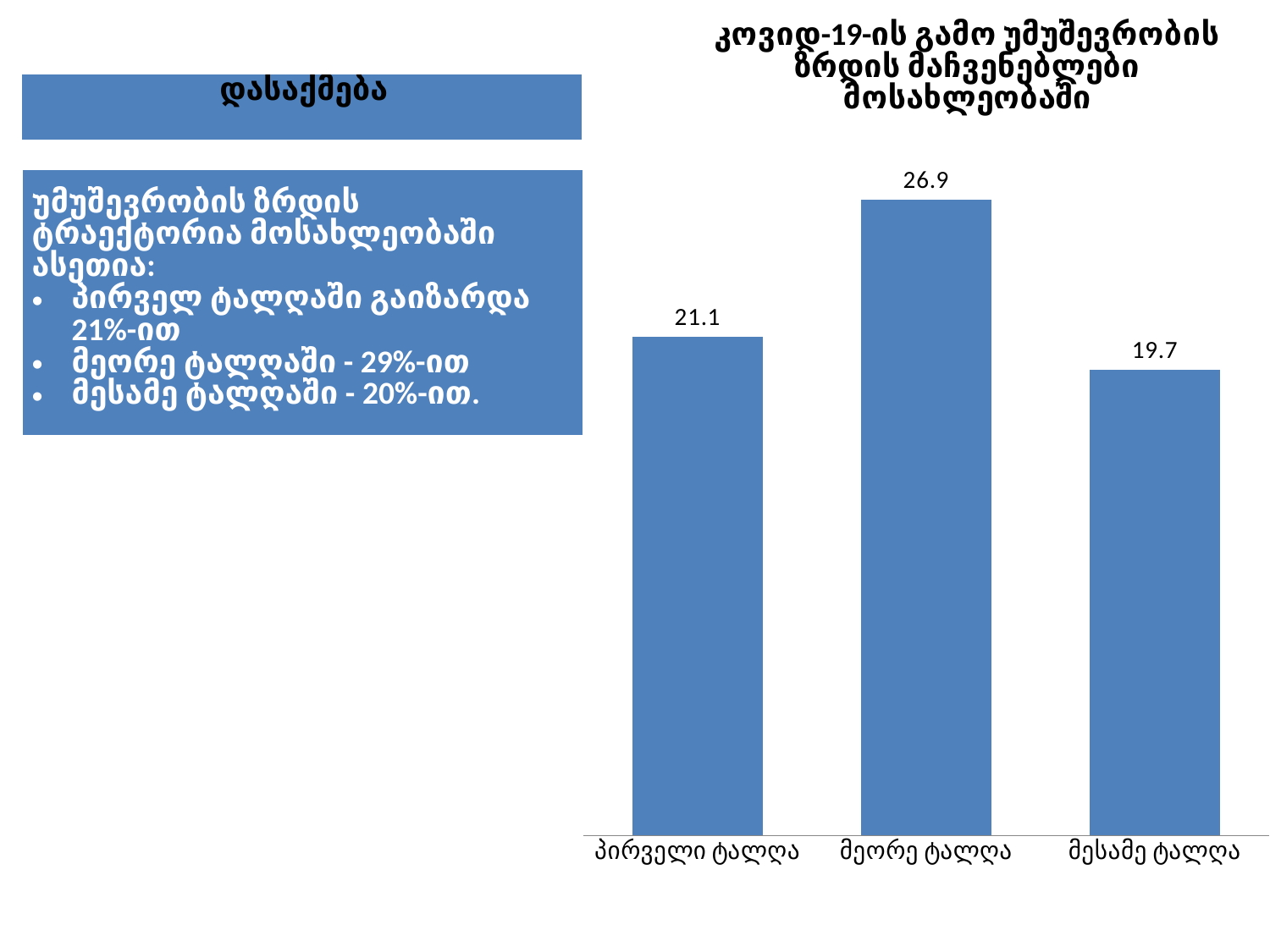
Which is larger, the value for მეორე ტალღა or the value for მესამე ტალღა? მეორე ტალღა Which category has the highest value? მეორე ტალღა Which category has the lowest value? მესამე ტალღა Does the value rise or fall from მეორე ტალღა to მესამე ტალღა? fall What kind of chart is shown on the slide? bar chart How many categories are shown in the chart? 3 What is the value for პირველი ტალღა? 21.1 What is the title of the chart? კოვიდ-19-ის გამო უმუშევრობის ზრდის მაჩვენებლები მოსახლეობაში What is the difference between the values for პირველი ტალღა and მესამე ტალღა? 1.4 What is the difference between the values for მეორე ტალღა and პირველი ტალღა? 5.8 What is the value for მესამე ტალღა? 19.7 What is the value for მეორე ტალღა? 26.9